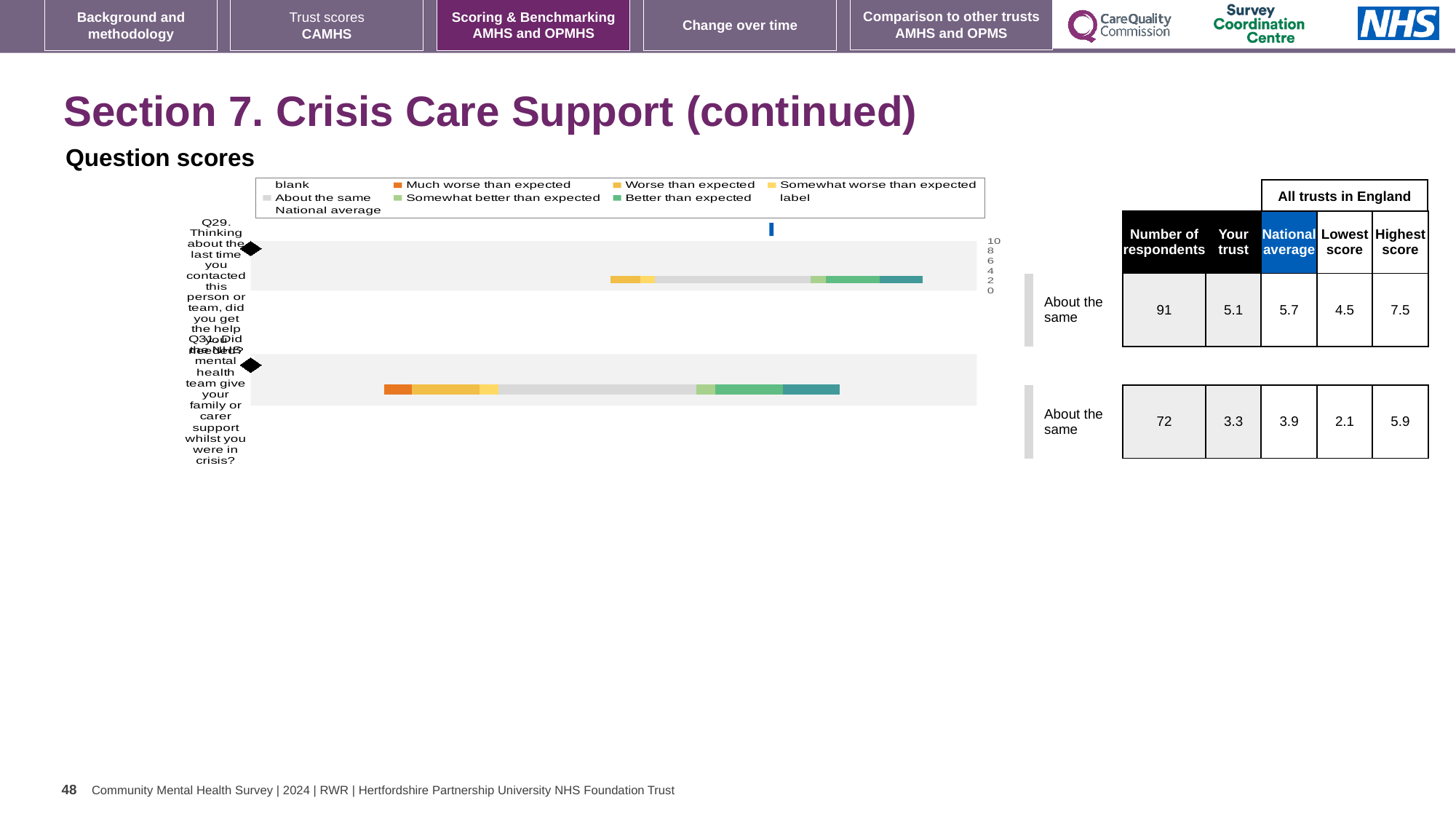
What is the highest score among all trusts in England for Q31? 5.9 In the legend of the question scores chart, what colour represents 'Much worse than expected'? Orange Which question has the higher 'Your trust' score, Q29 or Q31? Q29 What kind of chart is used to show the question scores on this slide? Bar chart What is the national average score for Q31? 3.9 What is the difference between the highest score and the lowest score for Q31? 3.8 How many respondents answered Q29? 91 What is the 'Your trust' score for Q29 in the question scores table? 5.1 In the legend of the question scores chart, what colour represents 'About the same'? Grey For Q29, which is larger: the 'Your trust' score or the national average? National average How many entries does the legend of the question scores chart list? 9 How many survey questions are plotted in the question scores chart? 2